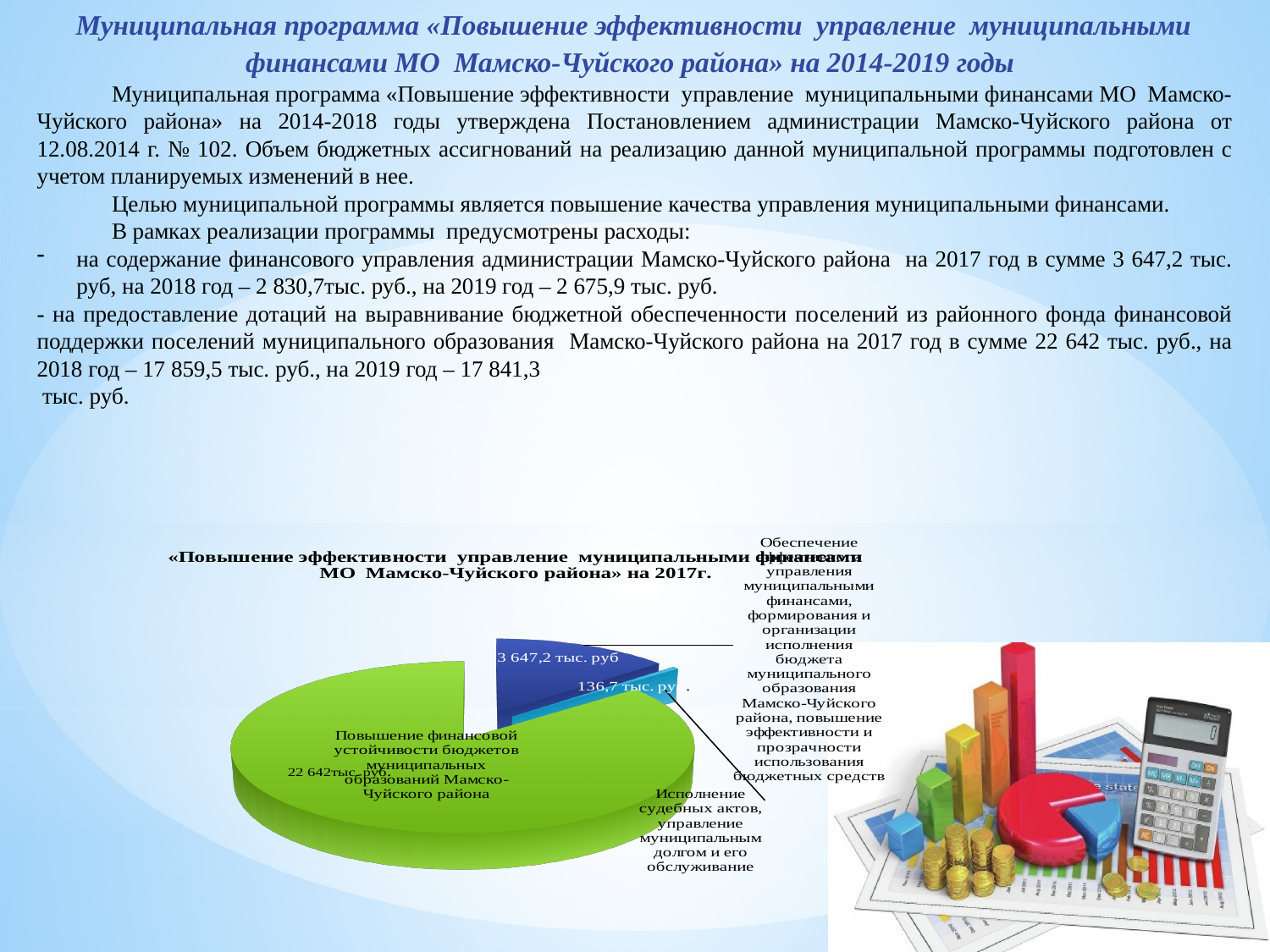
What year does the pie chart title refer to? 2017 Which is larger: the slice for «Обеспечение управления муниципальными финансами...» or the slice for «Исполнение судебных актов...»? Обеспечение управления муниципальными финансами... What is the difference between the value for «Повышение финансовой устойчивости бюджетов...» and the value for «Обеспечение управления муниципальными финансами...»? 18 994,8 тыс. руб. What is the value shown for the slice «Исполнение судебных актов, управление муниципальным долгом и его обслуживание»? 136,7 тыс. руб. Which slice of the pie chart is the largest? Повышение финансовой устойчивости бюджетов муниципальных образований Мамско-Чуйского района What is the value shown for the slice «Обеспечение управления муниципальными финансами, формирования и организации исполнения бюджета...»? 3 647,2 тыс. руб What kind of chart is shown on the slide? Pie chart How many slices does the pie chart have? 3 What is the difference between the value for «Обеспечение управления муниципальными финансами...» and the value for «Исполнение судебных актов...»? 3 510,5 тыс. руб. Which slice of the pie chart is the smallest? Исполнение судебных актов, управление муниципальным долгом и его обслуживание What is the value shown for the slice «Повышение финансовой устойчивости бюджетов муниципальных образований Мамско-Чуйского района»? 22 642 тыс. руб. What colour is the largest slice of the pie chart? Green